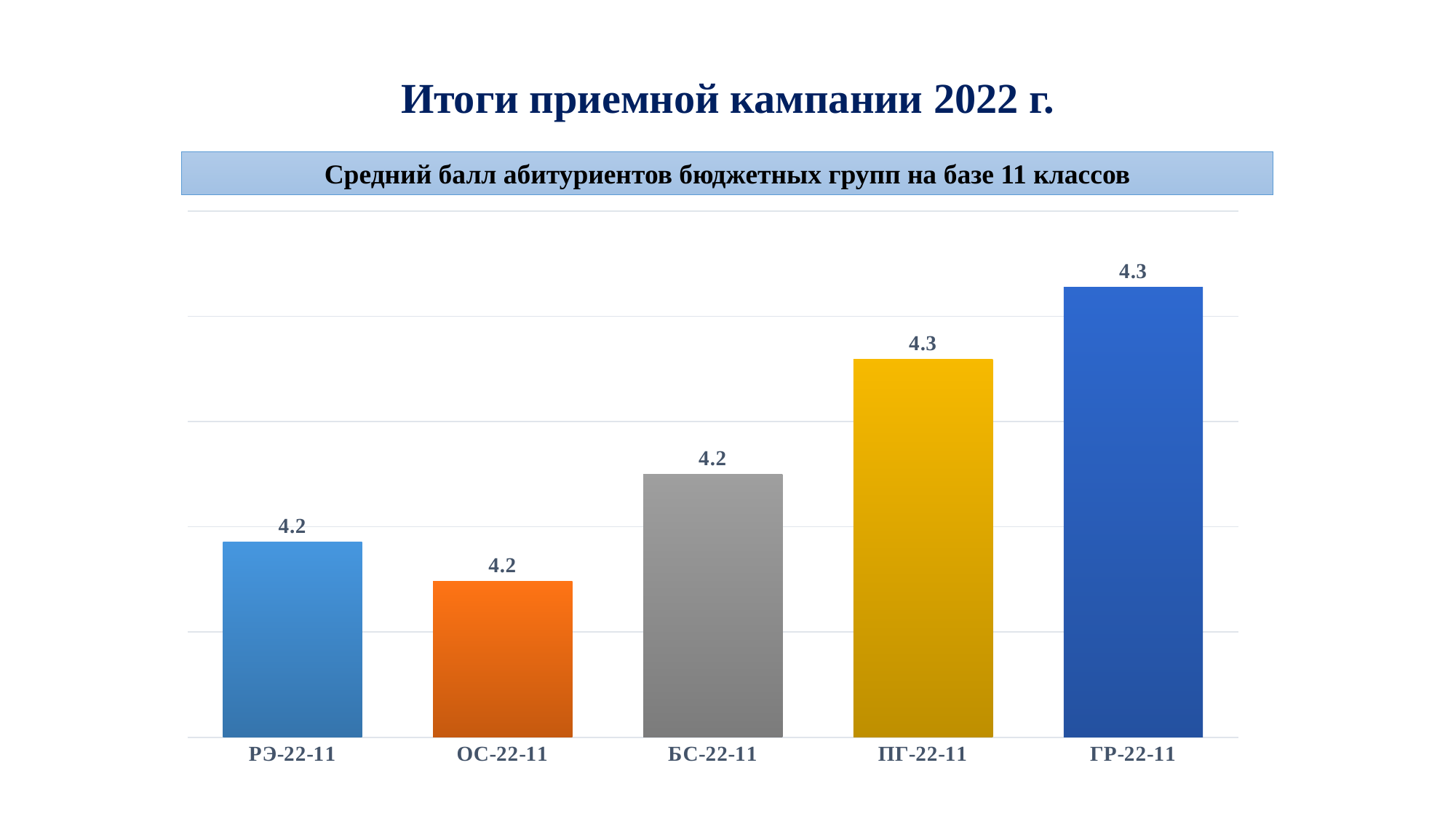
What is the average score shown for РЭ-22-11? 4.2 Which has the larger value, ОС-22-11 or ПГ-22-11? ПГ-22-11 What is the title of the chart? Средний балл абитуриентов бюджетных групп на базе 11 классов What is the average score shown for ОС-22-11? 4.2 What kind of chart is shown on the slide? Bar chart What is the average score shown for БС-22-11? 4.2 Which has the larger value, ГР-22-11 or РЭ-22-11? ГР-22-11 What colour is the bar for ПГ-22-11? Yellow What is the difference between the values for ПГ-22-11 and БС-22-11? 0.1 How many groups are shown on the chart? 5 What is the average score shown for ПГ-22-11? 4.3 What is the average score shown for ГР-22-11? 4.3